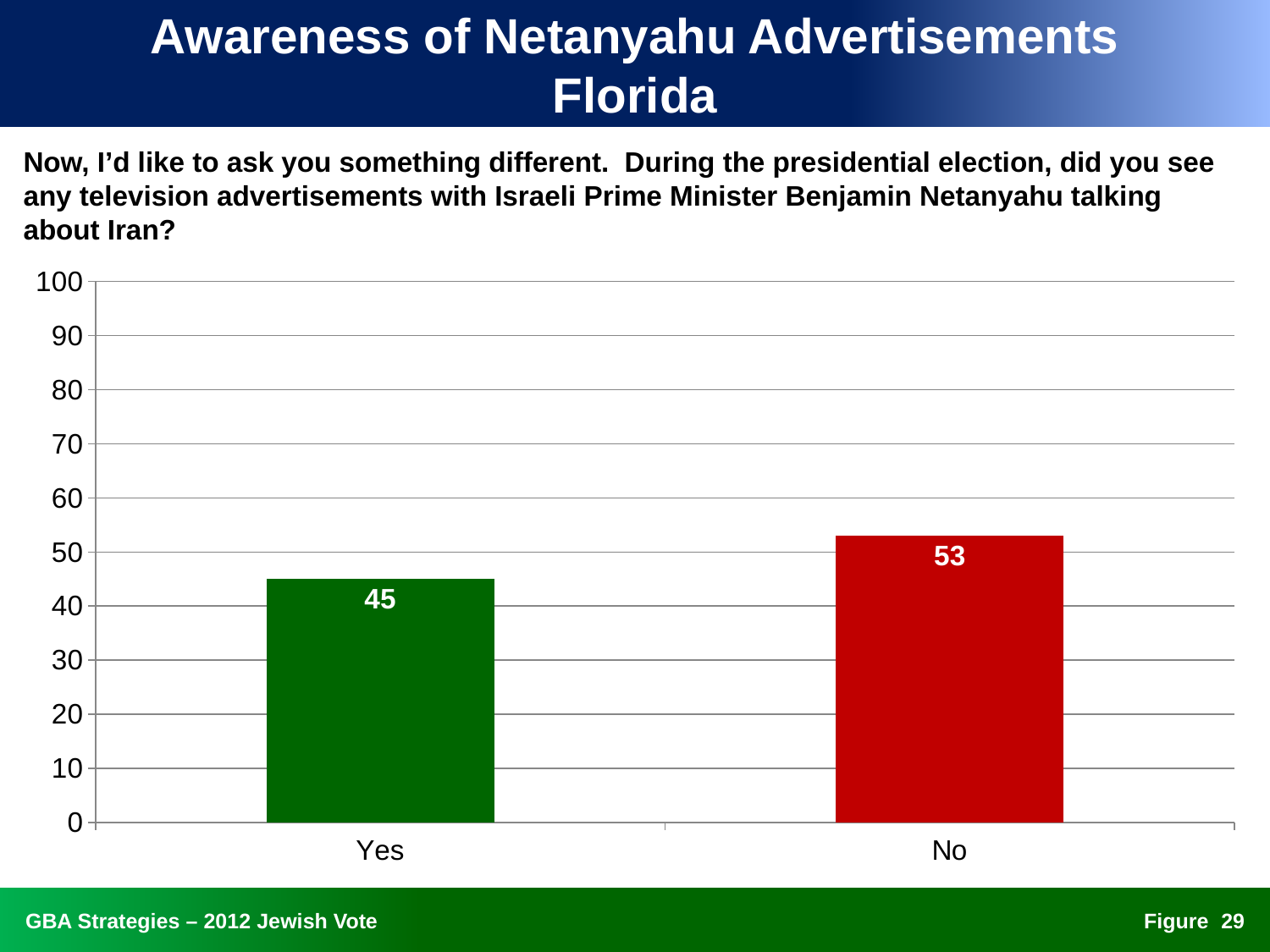
Which category has the lowest value? Yes What kind of chart is shown on the slide? bar chart What is the maximum value shown on the y axis? 100 Which is larger, the value for Yes or the value for No? No What colour is the bar for No? red Is the value for Yes greater or less than 50? less What is the value for Yes? 45 How many categories are shown on the x axis? 2 What is the difference between the values for No and Yes? 8 Which category has the highest value? No Is the value for No greater or less than 50? greater What is the value for No? 53